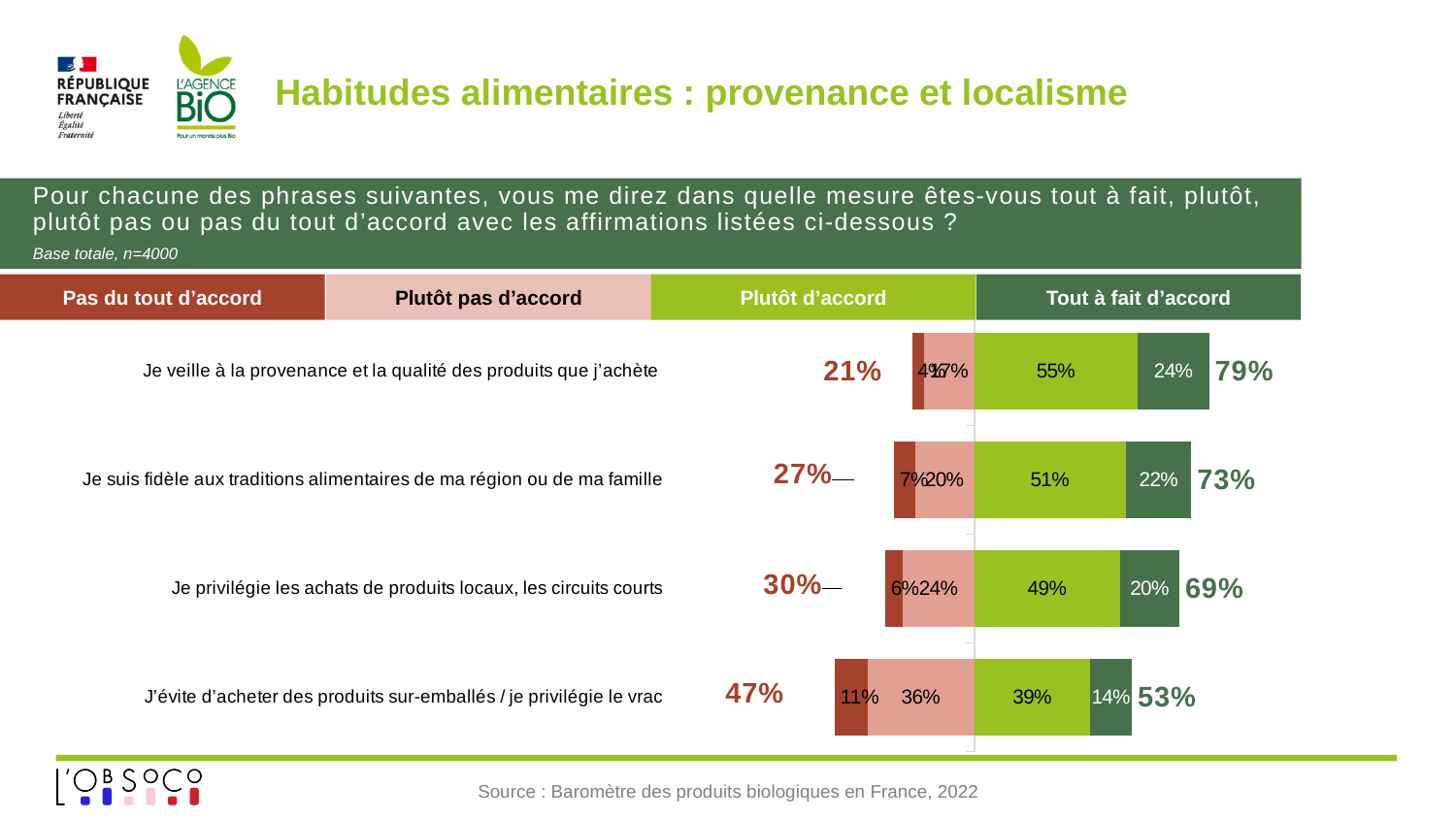
What is the combined disagreement total (Pas du tout d'accord + Plutôt pas d'accord) shown for 'J'évite d'acheter des produits sur-emballés / je privilégie le vrac'? 47% What is the 'Tout à fait d'accord' value for 'Je suis fidèle aux traditions alimentaires de ma région ou de ma famille'? 22% Which is larger: the 'Plutôt pas d'accord' value for 'Je suis fidèle aux traditions alimentaires de ma région ou de ma famille' or for 'Je privilégie les achats de produits locaux, les circuits courts'? Je privilégie les achats de produits locaux, les circuits courts Which statement has the highest combined agreement total (Plutôt d'accord + Tout à fait d'accord)? Je veille à la provenance et la qualité des produits que j'achète How many response categories does the legend list? 4 How many statements (categories) are plotted in the chart? 4 What is the difference between the 'Plutôt d'accord' values for 'Je veille à la provenance et la qualité des produits que j'achète' and 'J'évite d'acheter des produits sur-emballés / je privilégie le vrac'? 16% What kind of chart is shown on the slide? Stacked bar chart What is the 'Pas du tout d'accord' value for 'Je privilégie les achats de produits locaux, les circuits courts'? 6% What is the 'Plutôt d'accord' value for 'Je veille à la provenance et la qualité des produits que j'achète'? 55% Which statement has the lowest 'Tout à fait d'accord' value? J'évite d'acheter des produits sur-emballés / je privilégie le vrac What is the 'Plutôt pas d'accord' value for 'J'évite d'acheter des produits sur-emballés / je privilégie le vrac'? 36%